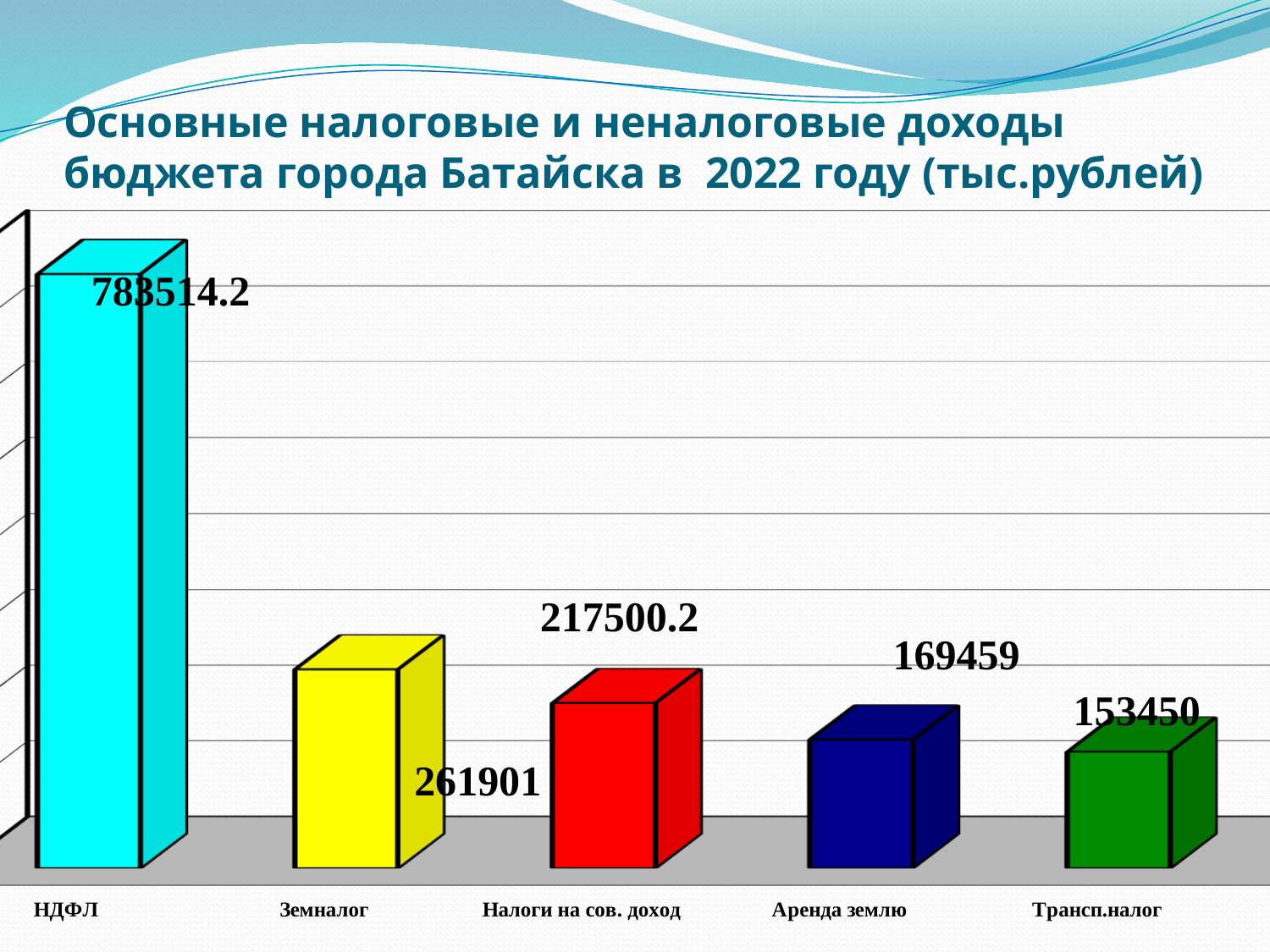
What is the value for Аренда землю? 169459 Which category has the lowest value? Трансп.налог What is the value for Земналог? 261901 How many categories are shown in the chart? 5 Which is larger, the value for Земналог or the value for Налоги на сов. доход? Земналог Which category has the highest value? НДФЛ What is the value for Трансп.налог? 153450 What is the value for Налоги на сов. доход? 217500.2 What is the difference between the values for Аренда землю and Трансп.налог? 16009 What is the difference between the values for НДФЛ and Земналог? 521613.2 What is the value for НДФЛ? 783514.2 What kind of chart is shown on the slide? Bar chart